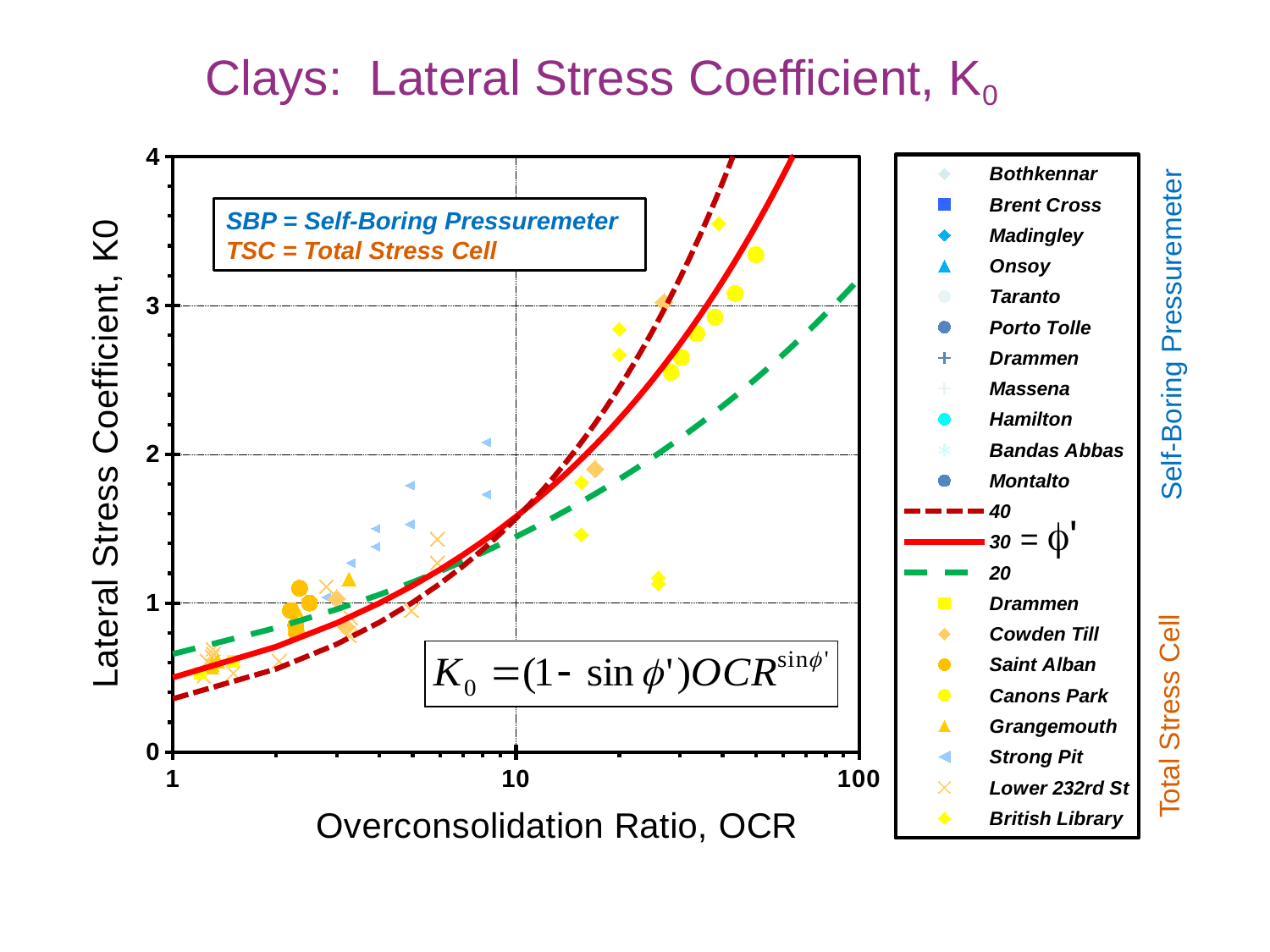
At OCR = 100, which curve is higher, φ' = 20 or φ' = 30? φ' = 30 Do the K0 values generally rise or fall as OCR increases along the x axis? rise How many φ' curves (dashed and solid lines) are plotted on the chart? 3 How many site entries does the legend list under Total Stress Cell? 8 What is the label of the x axis? Overconsolidation Ratio, OCR According to the text box on the chart, what does SBP stand for? Self-Boring Pressuremeter At OCR = 10, is the value of the φ' = 30 solid red curve greater or less than 2? less How many site entries does the legend list under Self-Boring Pressuremeter? 11 At OCR = 1, is the value of the φ' = 30 solid red curve greater or less than 1? less At OCR = 1, which curve is higher, φ' = 20 or φ' = 40? φ' = 20 What kind of chart is shown on the slide? scatter chart At OCR = 10, is the value of the φ' = 20 green dashed curve greater or less than 1? greater